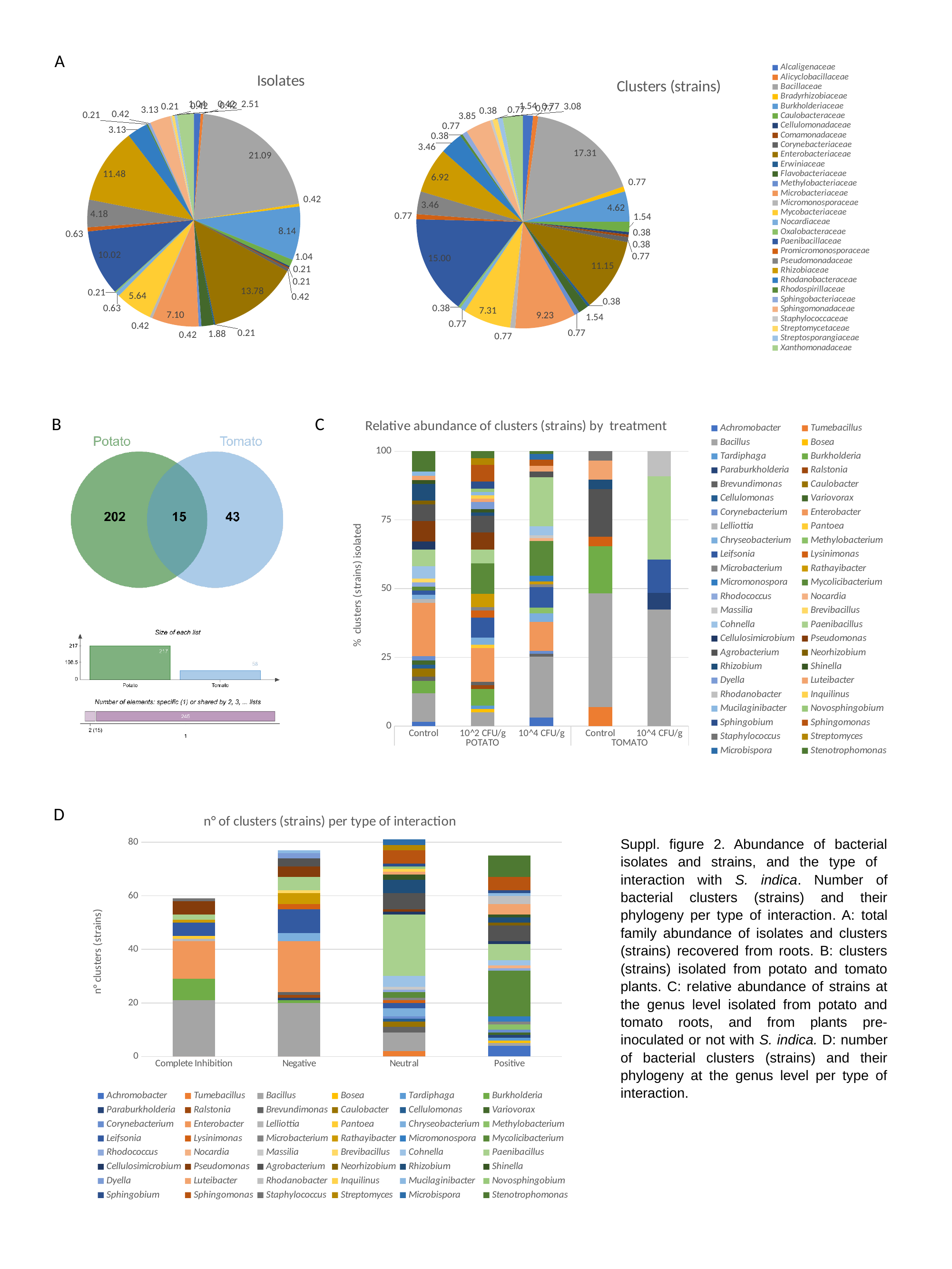
How many families are listed in the legend of panel A? 30 In the Isolates pie chart, what is the value of the largest slice? 21.09 In the chart 'n° of clusters (strains) per type of interaction', is the total for Positive greater or less than 60? greater In the 'Size of each list' bar chart in panel B, what is the value for Tomato? 58 In the 'Size of each list' bar chart in panel B, what is the value for Potato? 217 In the Isolates pie chart, what is the difference between the two largest slices (21.09 and 13.78)? 7.31 What kind of chart is 'n° of clusters (strains) per type of interaction' (panel D)? Stacked bar chart What kind of charts are shown in panel A? Pie charts In the Clusters (strains) pie chart, what is the value of the largest slice? 17.31 How many bars are plotted in the chart 'Relative abundance of clusters (strains) by treatment' (panel C)? 5 In the Clusters (strains) pie chart, which is larger: the slice labelled 15.00 or the slice labelled 11.15? 15.00 In the chart 'n° of clusters (strains) per type of interaction', which type of interaction has the lowest total number of clusters? Complete Inhibition